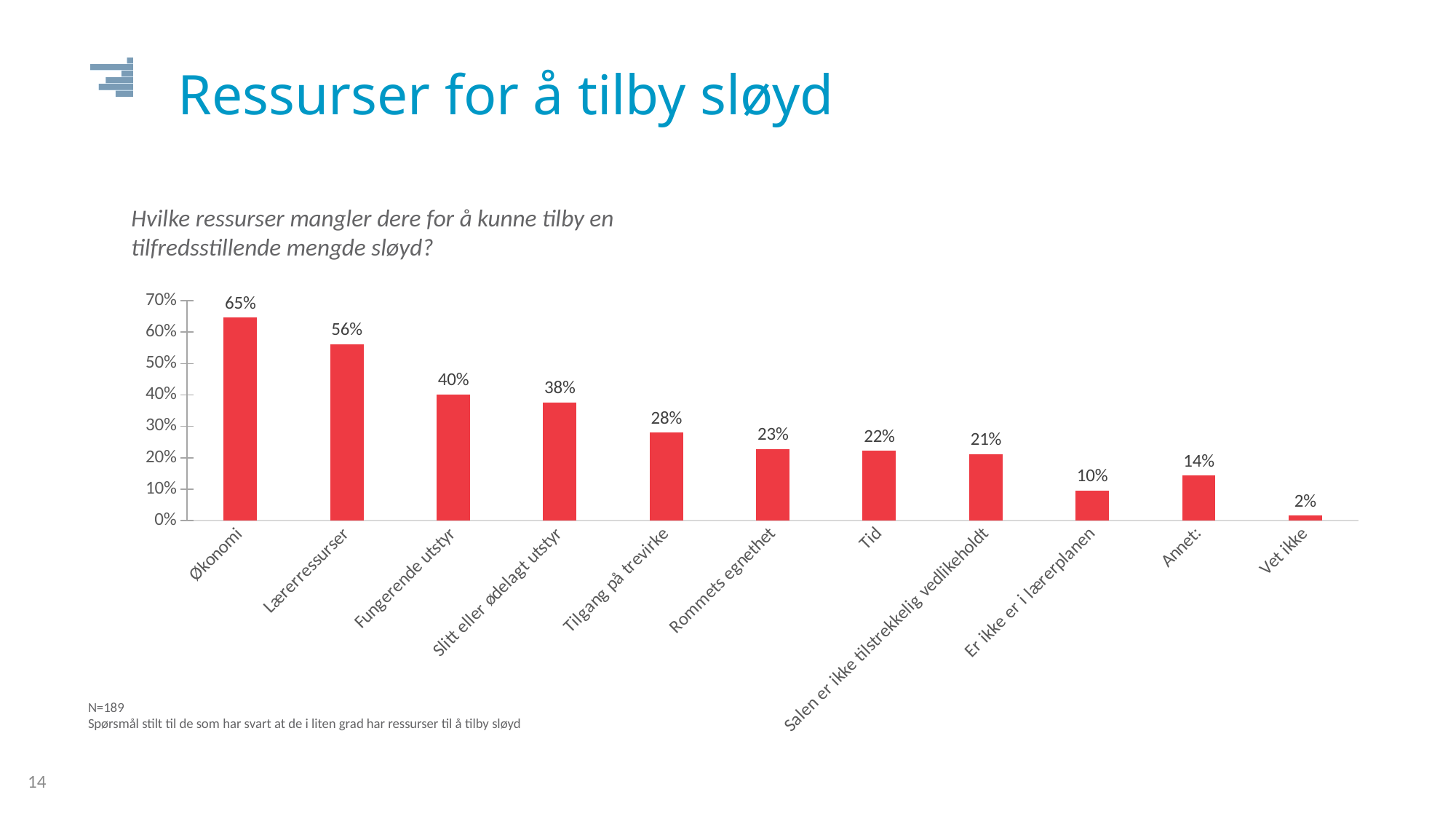
What is the difference between the values for Fungerende utstyr and Annet:? 26% What kind of chart is shown on the slide? bar chart Which category has the lowest value? Vet ikke How many categories are shown on the x axis? 11 Do the values rise or fall from left to right along the x axis? fall Which category has the highest value? Økonomi Which is larger, the value for Rommets egnethet or the value for Annet:? Rommets egnethet What is the value for Økonomi? 65% Is the value for Slitt eller ødelagt utstyr greater or less than 30%? greater What is the value for Tilgang på trevirke? 28% What is the difference between the values for Økonomi and Lærerressurser? 9% What is the value for Er ikke er i lærerplanen? 10%